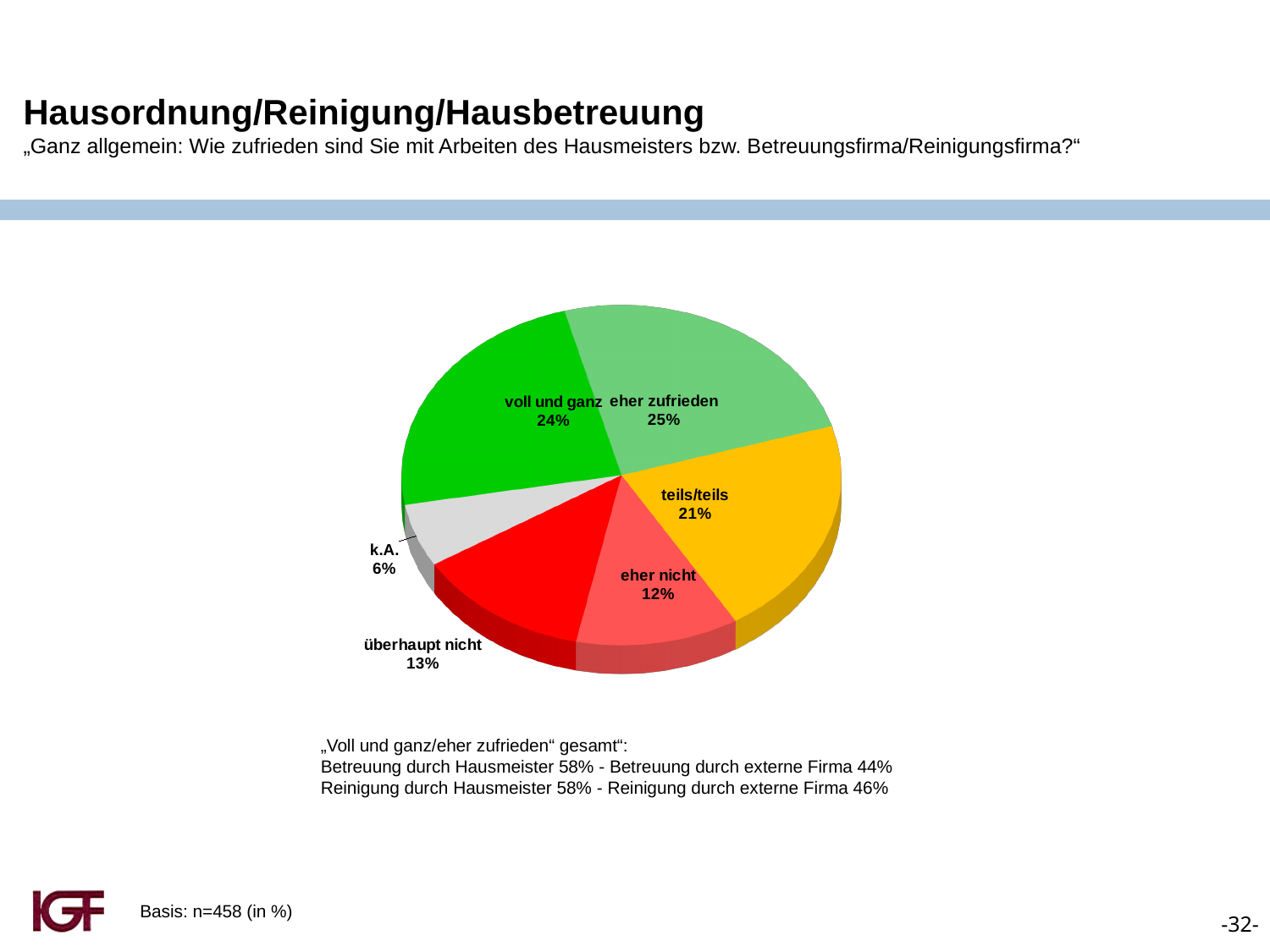
What is the combined share of "voll und ganz" and "eher zufrieden"? 49% What colour is the "teils/teils" slice? yellow How many slices does the pie chart have? 6 What kind of chart is shown on the slide? pie chart Which is larger, "überhaupt nicht" or "eher nicht"? überhaupt nicht Which slice of the pie is the smallest? k.A. What is the value for "k.A."? 6% What is the difference between "eher zufrieden" and "eher nicht"? 13% Which slice of the pie is the largest? eher zufrieden What is the value for "teils/teils"? 21% What is the value for "voll und ganz"? 24% What share of the pie is labelled "eher zufrieden"? 25%